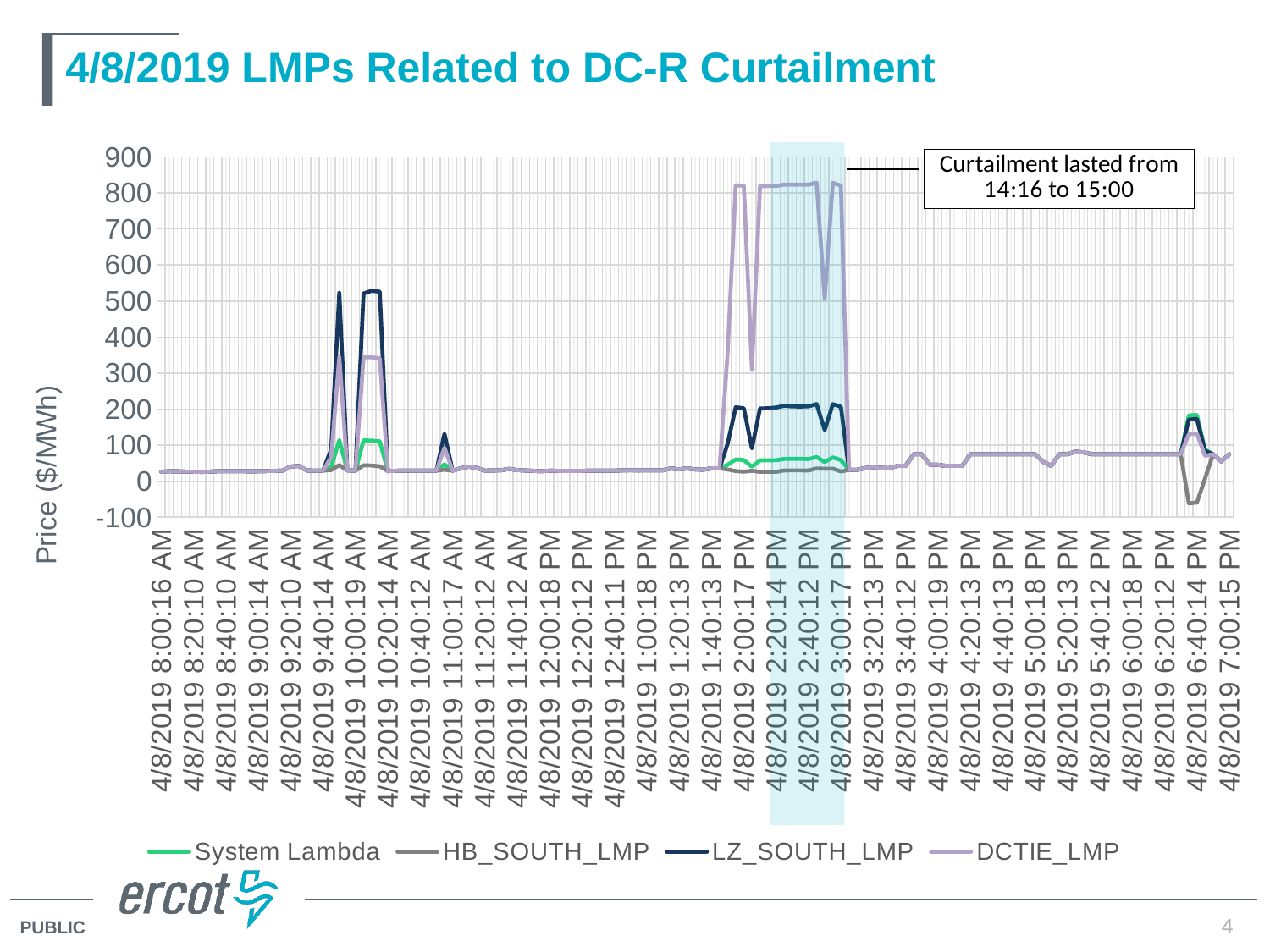
Is the lowest value of HB_SOUTH_LMP around 6:40 PM greater or less than 0? less Which series reaches the highest value during the shaded curtailment period? DCTIE_LMP What kind of chart is shown on the slide? Line chart Is the peak value of DCTIE_LMP during the curtailment period greater or less than 700? greater How many series does the legend list? 4 Is the value of System Lambda during the curtailment period greater or less than 100? less During the curtailment period, which is larger: LZ_SOUTH_LMP or System Lambda? LZ_SOUTH_LMP According to the annotation on the chart, when did the curtailment last? From 14:16 to 15:00 Which series has the lowest value around 6:40 PM? HB_SOUTH_LMP What is the title of the chart? 4/8/2019 LMPs Related to DC-R Curtailment